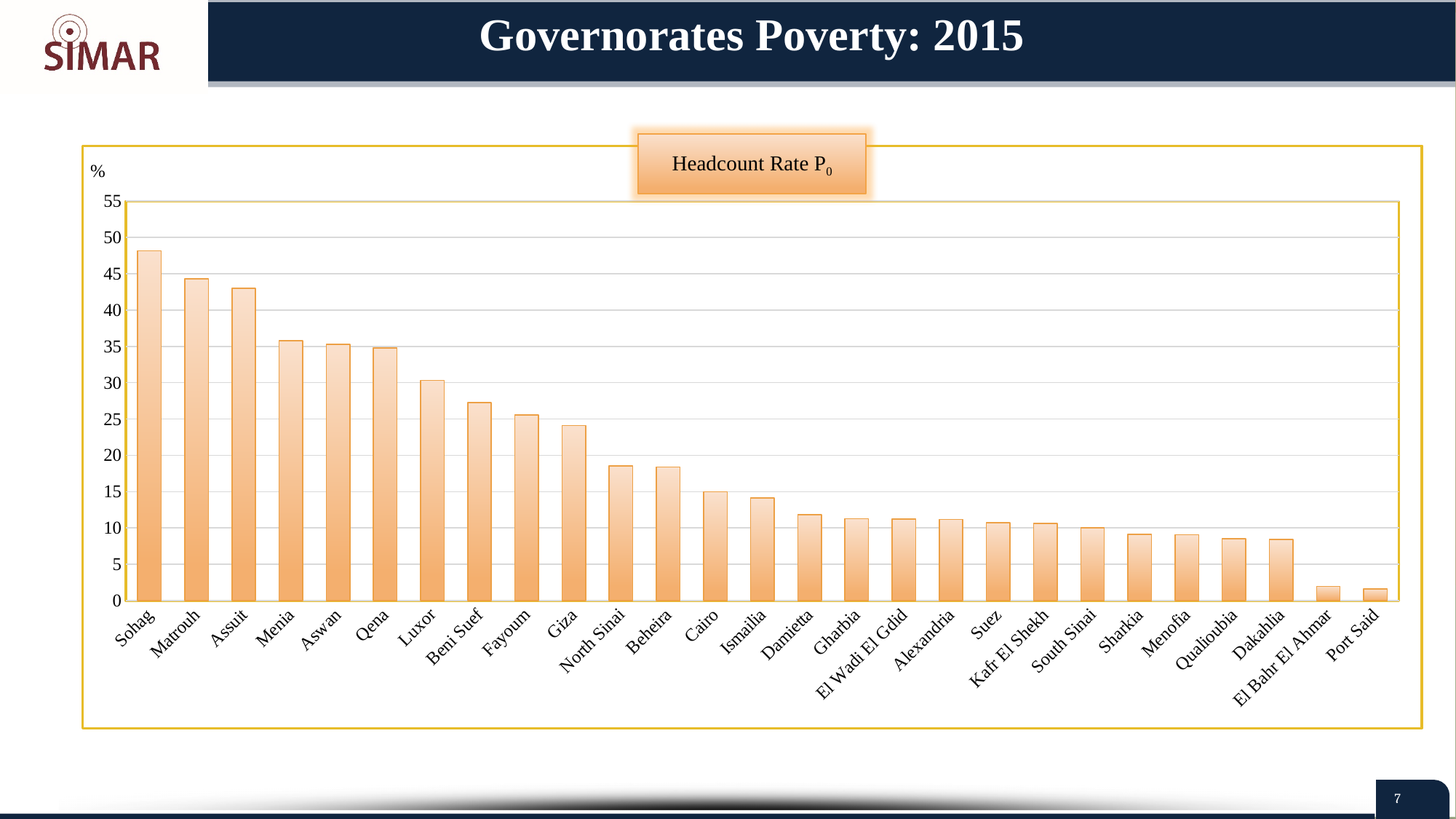
What is the title of the chart? Governorates Poverty: 2015 Is the value for Port Said greater or less than 5? less Which governorate has the lowest headcount poverty rate? Port Said Is the value for Giza greater or less than 25? less Which governorate has the highest headcount poverty rate? Sohag Which has a higher headcount poverty rate, Assuit or Menia? Assuit Is the value for Beni Suef greater or less than 25? greater Do the values rise or fall moving from left to right along the x axis? fall How many governorates are shown on the x axis? 27 What kind of chart is shown on the slide? bar chart